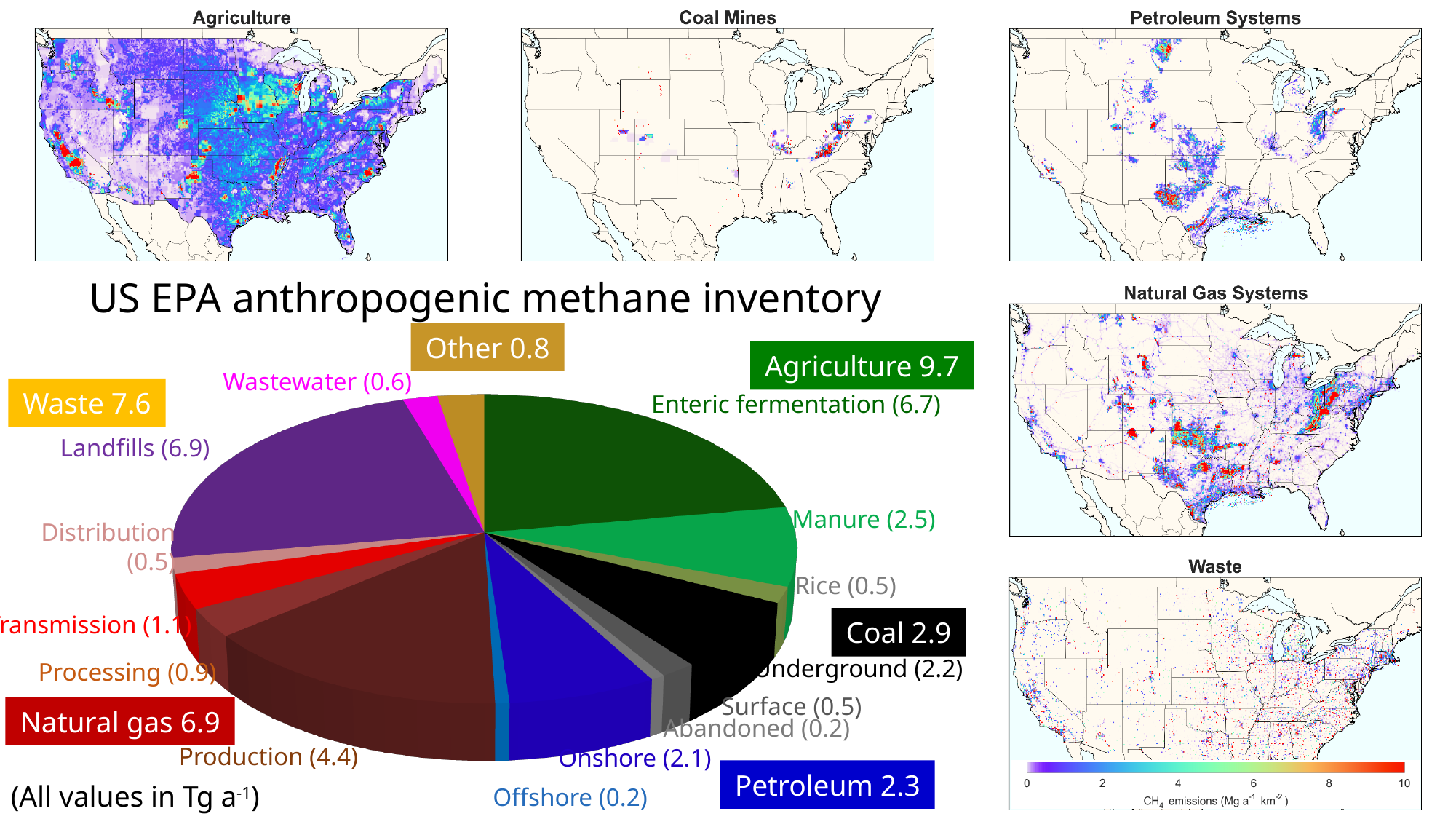
In the US EPA anthropogenic methane inventory pie chart, what is the value for Landfills? 6.9 In the US EPA anthropogenic methane inventory pie chart, which is larger, Coal or Petroleum? Coal In the US EPA anthropogenic methane inventory pie chart, what is the value for Agriculture? 9.7 In the US EPA anthropogenic methane inventory pie chart, what is the difference between Enteric fermentation and Manure? 4.2 In the US EPA anthropogenic methane inventory pie chart, which major sector has the smallest value? Other What kind of chart is used for the US EPA anthropogenic methane inventory? pie chart What unit are the values in the US EPA anthropogenic methane inventory pie chart given in? Tg a-1 In the US EPA anthropogenic methane inventory pie chart, how many major sectors are labelled with a coloured box? 6 In the US EPA anthropogenic methane inventory pie chart, what is the difference between the Waste value and the Natural gas value? 0.7 In the US EPA anthropogenic methane inventory pie chart, what is the value for Production under Natural gas? 4.4 In the US EPA anthropogenic methane inventory pie chart, which major sector has the largest value? Agriculture In the US EPA anthropogenic methane inventory pie chart, what is the value for Enteric fermentation? 6.7